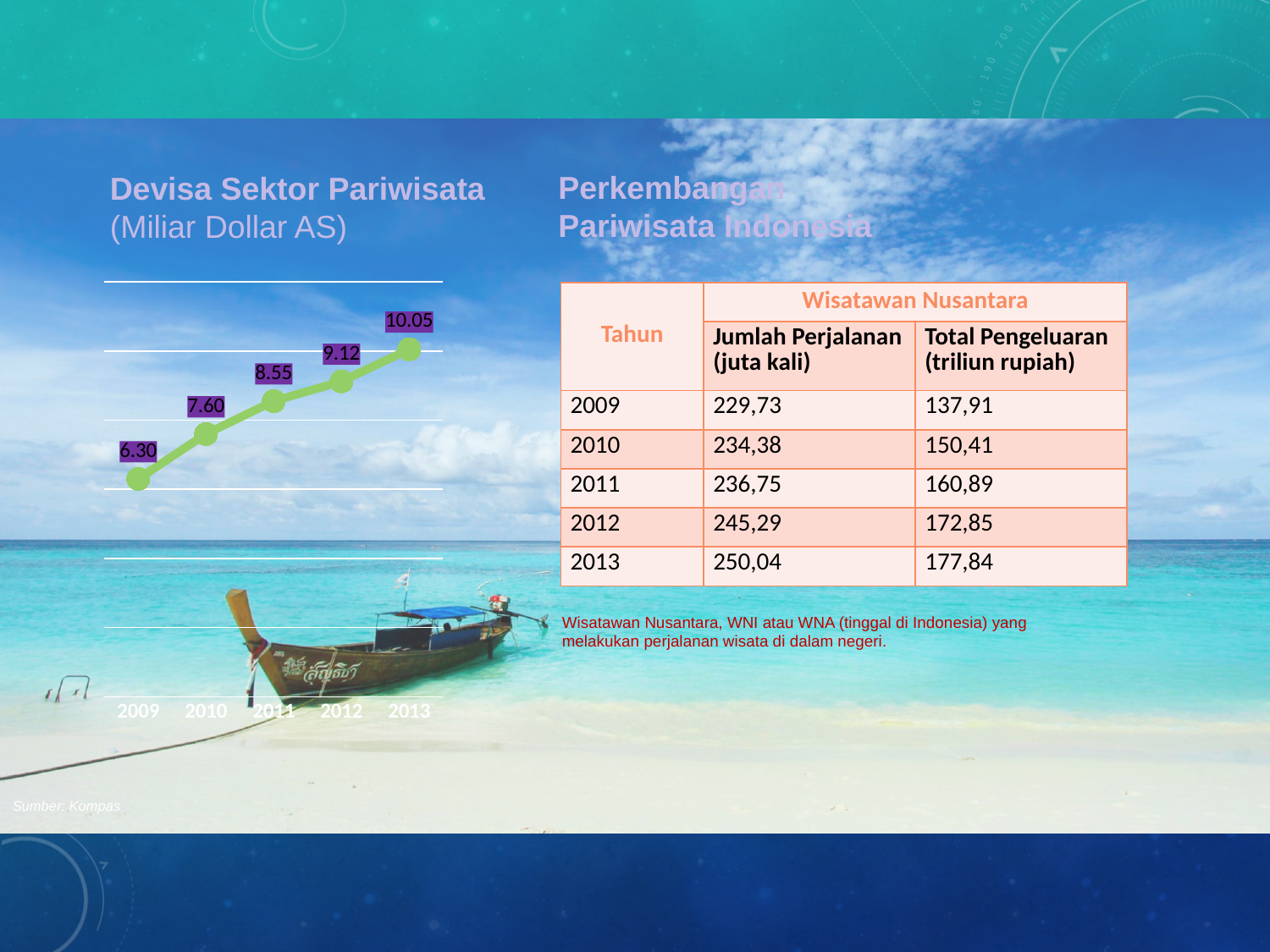
Which year has the lowest value in the Devisa Sektor Pariwisata chart? 2009 What is the difference between the 2010 and 2009 values in the Devisa Sektor Pariwisata chart? 1.30 How many years are plotted in the Devisa Sektor Pariwisata chart? 5 What is the value for 2009 in the Devisa Sektor Pariwisata chart? 6.30 What is the value for 2011 in the Devisa Sektor Pariwisata chart? 8.55 Do the values in the Devisa Sektor Pariwisata chart rise or fall from 2009 to 2013? rise What is the value for 2012 in the Devisa Sektor Pariwisata chart? 9.12 What is the value for 2013 in the Devisa Sektor Pariwisata chart? 10.05 Which year has the highest value in the Devisa Sektor Pariwisata chart? 2013 What is the difference between the 2013 and 2009 values in the Devisa Sektor Pariwisata chart? 3.75 What type of chart is used for Devisa Sektor Pariwisata (Miliar Dollar AS)? line chart In the Devisa Sektor Pariwisata chart, is the value for 2011 larger than the value for 2010? Yes